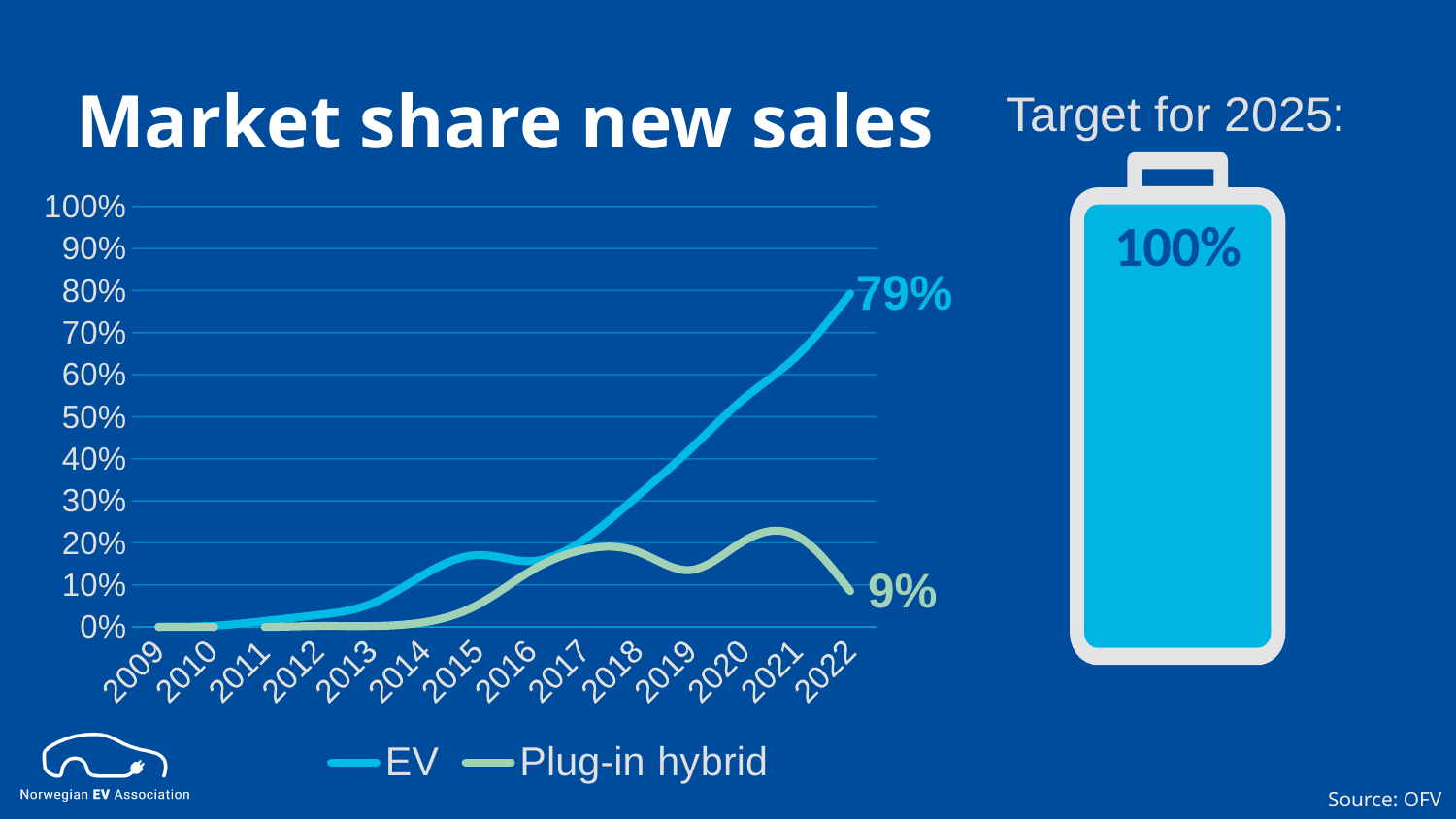
What type of chart is used to show market share of new sales? Line chart By how many percentage points does the EV share exceed the plug-in hybrid share in 2022? 70 percentage points Does the EV market share rise or fall from 2009 to 2022? Rises How many years are shown on the x axis of the chart? 14 What is the plug-in hybrid market share shown for 2022? 9% Is the EV market share in 2019 greater or less than 30%? greater In 2022, which series has the larger market share, EV or plug-in hybrid? EV What is the target market share for 2025 shown on the slide? 100% Is the plug-in hybrid market share in 2015 greater or less than 10%? less What is the EV market share shown for 2022? 79% How many series does the chart's legend list? 2